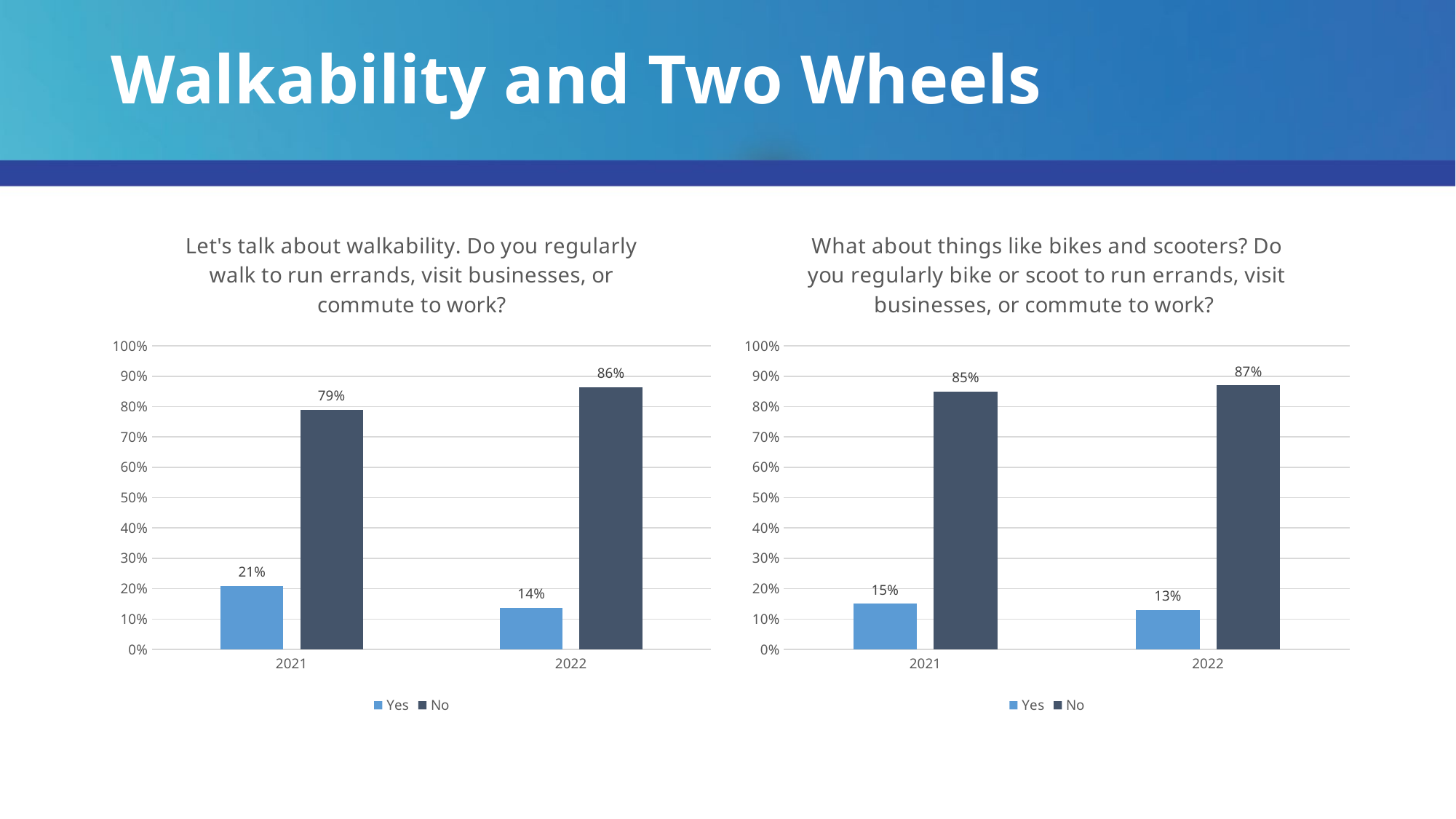
In the walkability chart on the left, what percentage answered Yes in 2021? 21% In the walkability chart on the left, by how many percentage points did the Yes share fall from 2021 to 2022? 7 percentage points In the walkability chart on the left, which year has the higher Yes value? 2021 In the walkability chart on the left, does the Yes value rise or fall from 2021 to 2022? Fall What type of chart is used on the right side of the slide? Bar chart In the bikes and scooters chart on the right, what percentage answered No in 2021? 85% How many series does the legend list in the walkability chart on the left? 2 In the bikes and scooters chart on the right, which bar is the lowest? Yes in 2022 (13%) In the bikes and scooters chart on the right, what percentage answered Yes in 2022? 13% In the bikes and scooters chart on the right, which bar is the tallest? No in 2022 (87%) In the bikes and scooters chart on the right, what is the difference between the No and Yes values in 2022? 74 percentage points In the walkability chart on the left, what percentage answered No in 2022? 86%